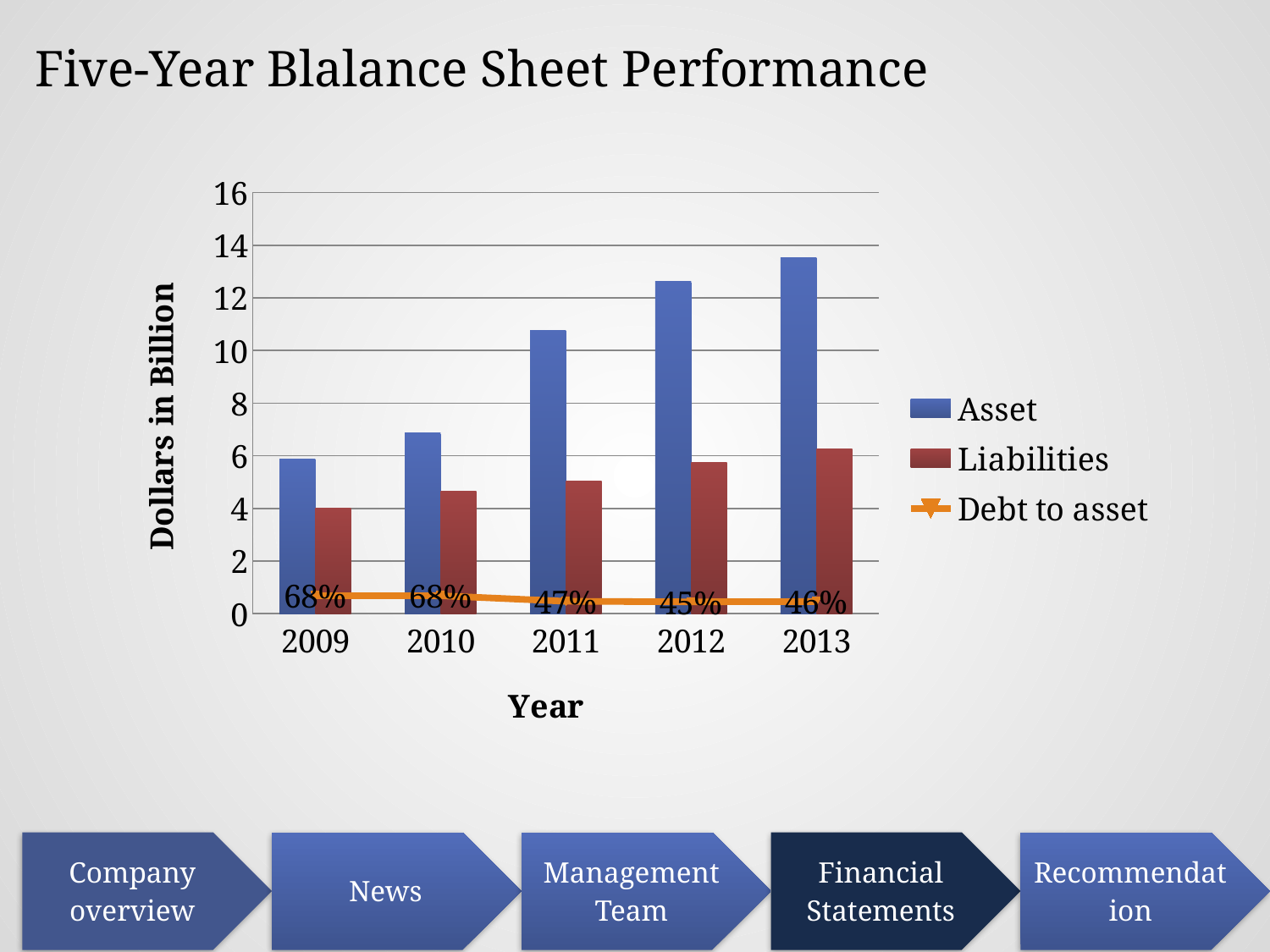
In which year is the Liabilities bar lowest? 2009 In which year is the Asset bar highest? 2013 What is the Debt to asset value for 2011? 47% What is the difference between the Debt to asset values for 2009 and 2012? 23 percentage points In which year is the Debt to asset value lowest? 2012 How many years are shown on the x axis? 5 Is the Asset value for 2011 greater or less than 10? greater In 2013, which is larger, Asset or Liabilities? Asset What is the Debt to asset value for 2013? 46% How many series does the legend list? 3 What is the title of the vertical axis? Dollars in Billion Do the Asset values rise or fall from 2009 to 2013? rise